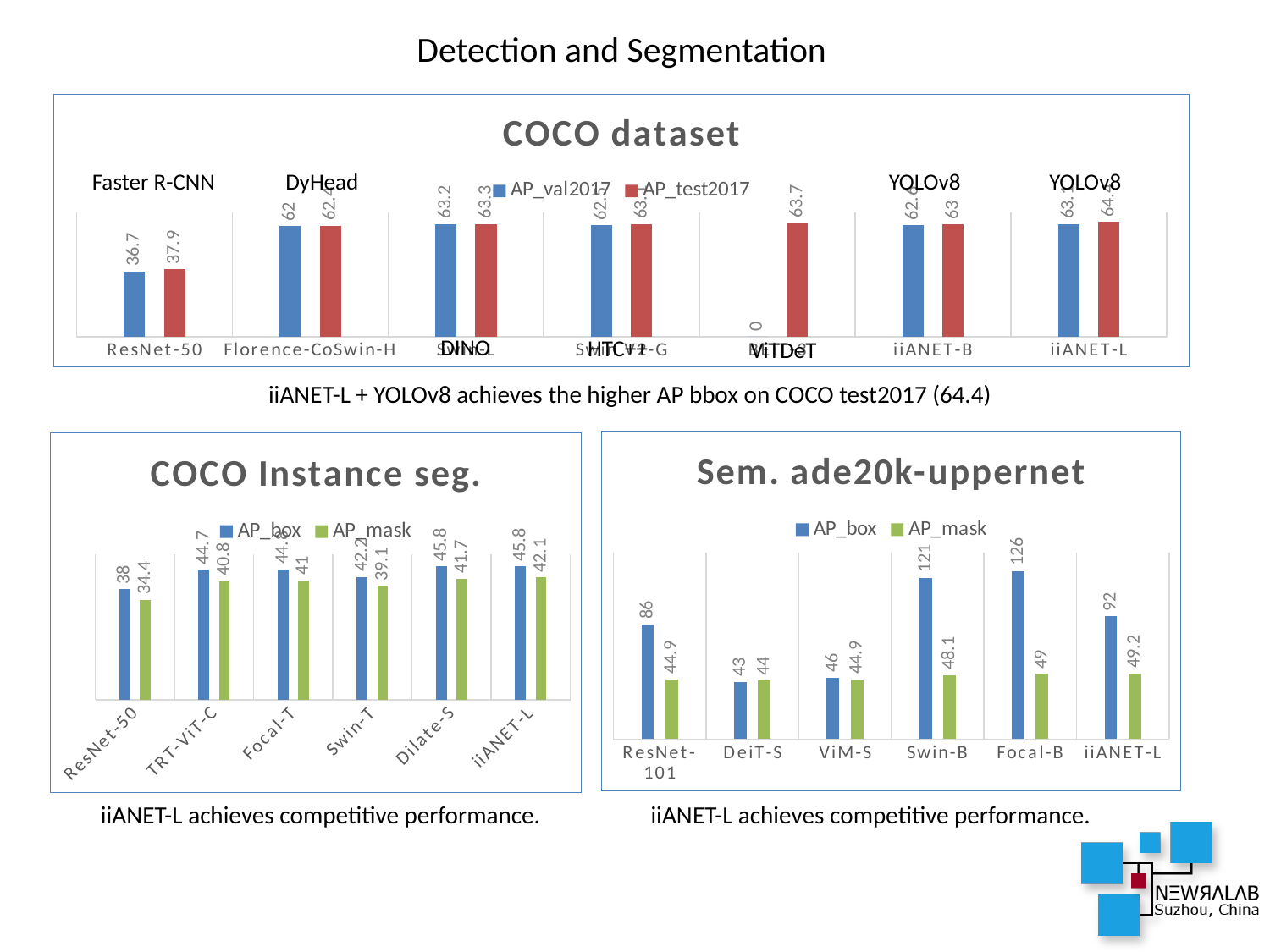
How many categories are shown on the x axis of the Sem. ade20k-uppernet chart? 6 In the Sem. ade20k-uppernet chart, which category has the highest AP_box value? Focal-B In the COCO dataset chart, what is the AP_val2017 value for Florence-CoSwin-H? 62 In the COCO dataset chart, what is the AP_test2017 value for ResNet-50? 37.9 In the COCO Instance seg. chart, what is the difference between AP_box and AP_mask for TRT-ViT-C? 3.9 In the COCO dataset chart, which category has the lowest AP_val2017 value? ViTDeT In the Sem. ade20k-uppernet chart, is the AP_box value larger for ResNet-101 or for iiANET-L? iiANET-L In the COCO Instance seg. chart, which category has the lowest AP_mask value? ResNet-50 In the COCO dataset chart, how many series does the legend list? 2 In the COCO Instance seg. chart, what is the AP_mask value for Dilate-S? 41.7 In the COCO dataset chart, what is the AP_test2017 value for ViTDeT? 63.7 In the Sem. ade20k-uppernet chart, what is the AP_box value for Swin-B? 121